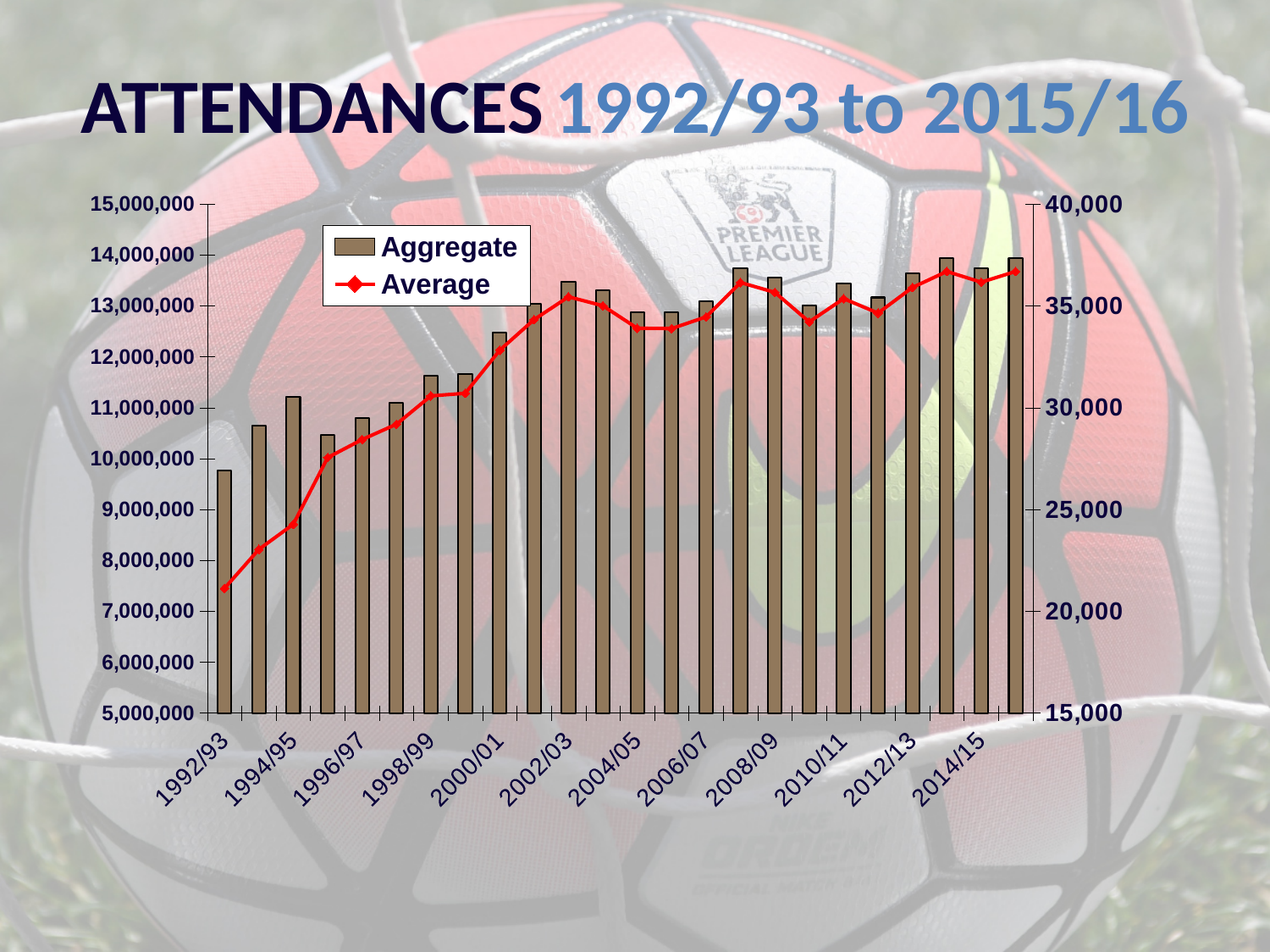
Overall, do the Average attendance values rise or fall from 1992/93 to 2015/16? rise Which series is plotted as bars? Aggregate What kind of chart is shown on the slide? A bar chart combined with a line chart Which season has the larger Aggregate attendance, 2000/01 or 2002/03? 2002/03 Is the Average value for 1992/93 greater or less than 25,000? less Is the Aggregate value for 1992/93 greater or less than 9,000,000? greater Which two series are listed in the chart legend? Aggregate and Average How many series does the legend list? 2 Is the Aggregate value for 1994/95 greater or less than 10,000,000? greater How many seasons (bars) are plotted in the chart? 24 Which season has the lowest Aggregate attendance? 1992/93